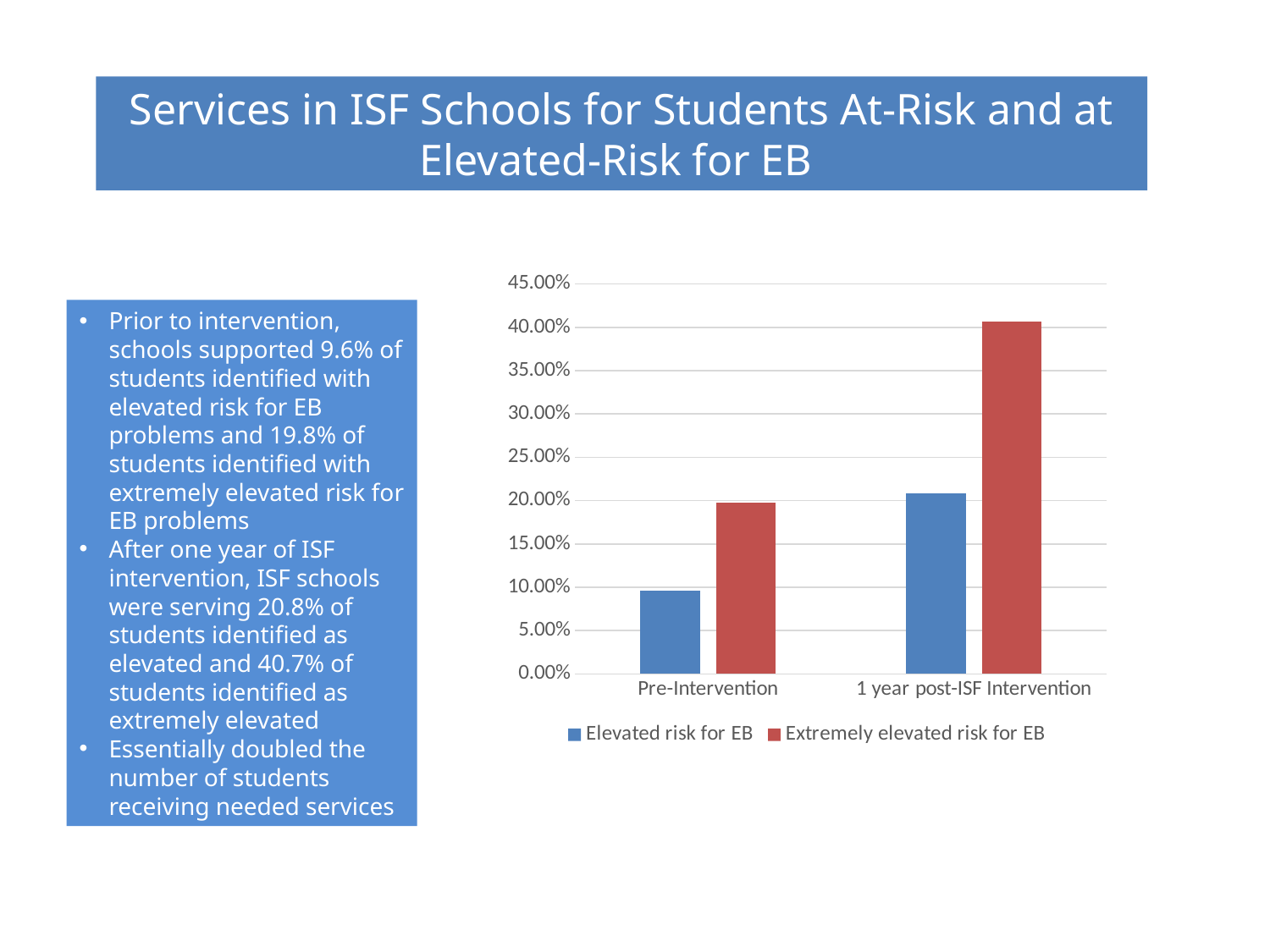
Is the value for Extremely elevated risk for EB at 1 year post-ISF Intervention greater or less than 40.00%? greater Is the value for Extremely elevated risk for EB at Pre-Intervention greater or less than 20.00%? less Which bar is the shortest in the chart? Elevated risk for EB, Pre-Intervention Which series is shown in red in the chart? Extremely elevated risk for EB What kind of chart is shown on the slide? bar chart Is the value for Elevated risk for EB at Pre-Intervention greater or less than 10.00%? less Which bar is the tallest in the chart? Extremely elevated risk for EB, 1 year post-ISF Intervention How many categories are shown on the x axis of the chart? 2 Which is larger: Elevated risk for EB at 1 year post-ISF Intervention or Extremely elevated risk for EB at Pre-Intervention? Elevated risk for EB at 1 year post-ISF Intervention How many series does the chart legend list? 2 Do the values for Extremely elevated risk for EB rise or fall from Pre-Intervention to 1 year post-ISF Intervention? rise